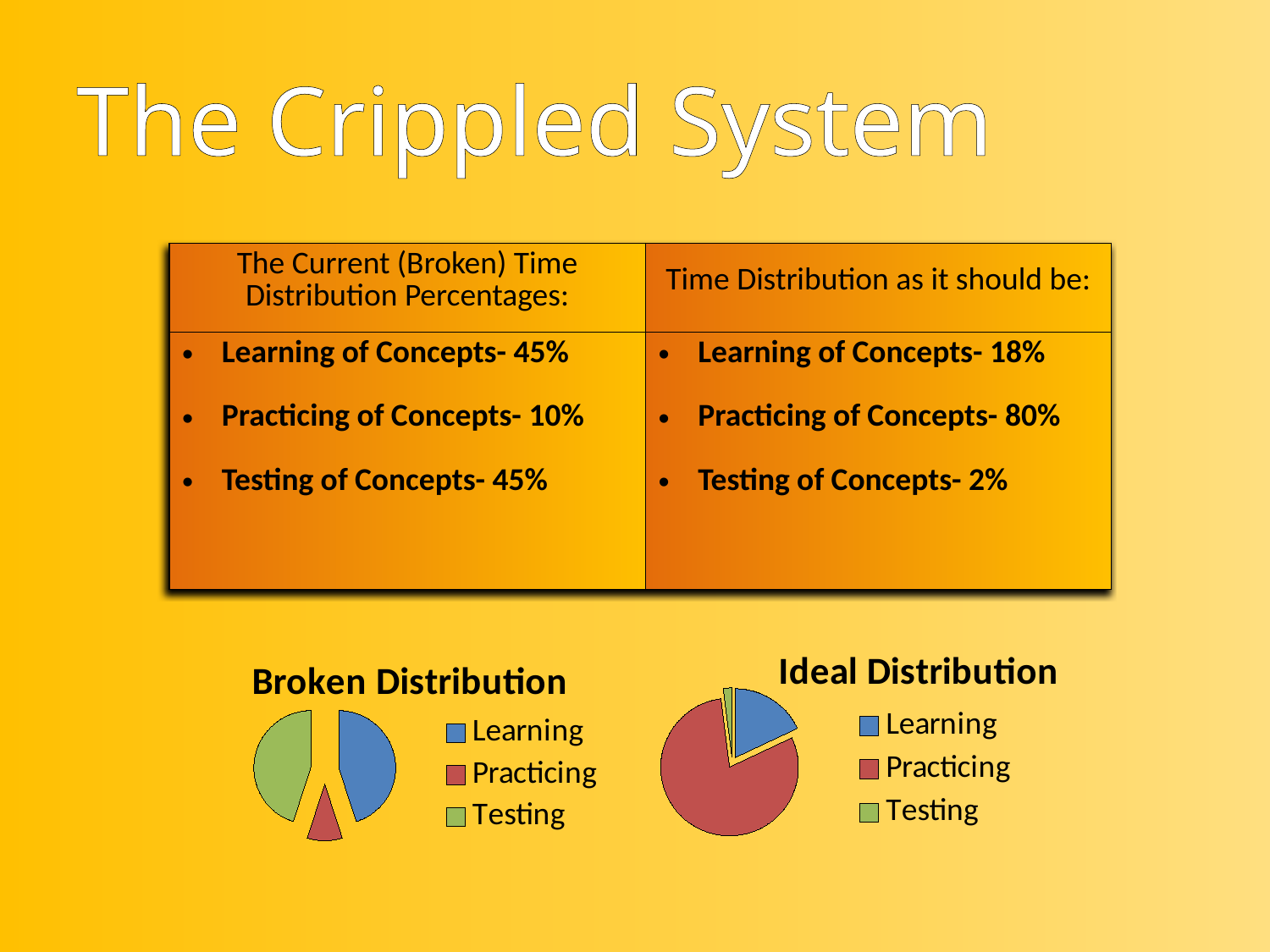
What kind of chart is the Broken Distribution chart? pie chart How many slices does the Ideal Distribution pie chart have? 3 In the Ideal Distribution chart, which is larger, Learning or Testing? Learning How many slices does the Broken Distribution pie chart have? 3 In the Ideal Distribution chart, which category has the largest slice? Practicing In the Broken Distribution chart, which category has the smallest slice? Practicing What colour represents Practicing in the Ideal Distribution chart? red What kind of chart is the Ideal Distribution chart? pie chart In the Ideal Distribution chart, which category has the smallest slice? Testing What is the title of the pie chart on the left of the slide? Broken Distribution How many entries does the legend of the Ideal Distribution chart list? 3 In the Broken Distribution chart, which is larger, Learning or Practicing? Learning